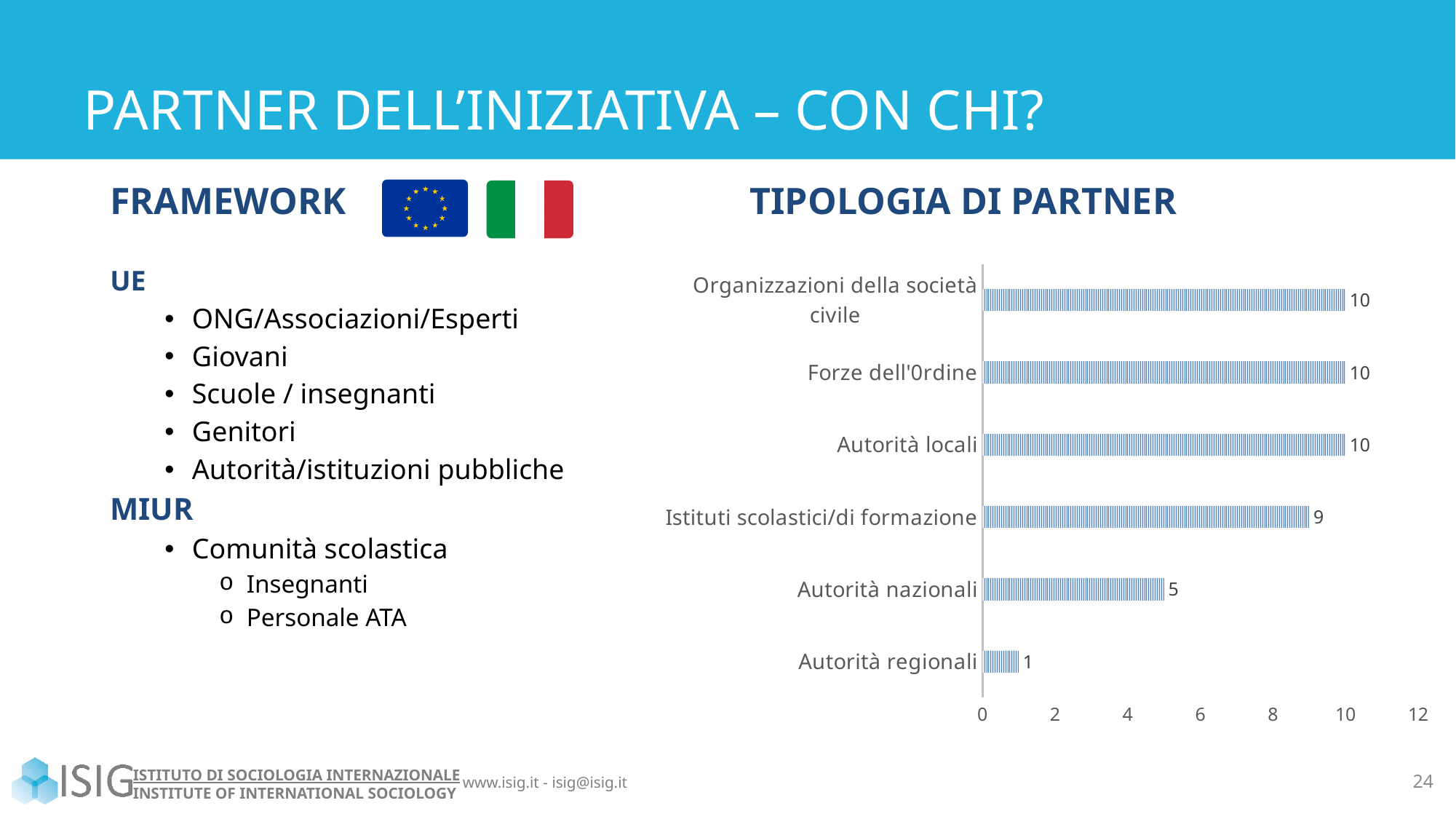
Is the value for Autorità nazionali greater or less than 4? greater What is the value for Autorità nazionali? 5 What is the value for Autorità regionali? 1 What is the value for Forze dell'0rdine? 10 How many categories are shown in the chart? 6 What is the difference between the values for Istituti scolastici/di formazione and Autorità nazionali? 4 What is the difference between the values for Autorità locali and Autorità regionali? 9 Which is larger, the value for Autorità nazionali or the value for Istituti scolastici/di formazione? Istituti scolastici/di formazione What kind of chart is shown on the slide? bar chart Which category has the lowest value? Autorità regionali What is the value for Istituti scolastici/di formazione? 9 What is the title of the chart? TIPOLOGIA DI PARTNER